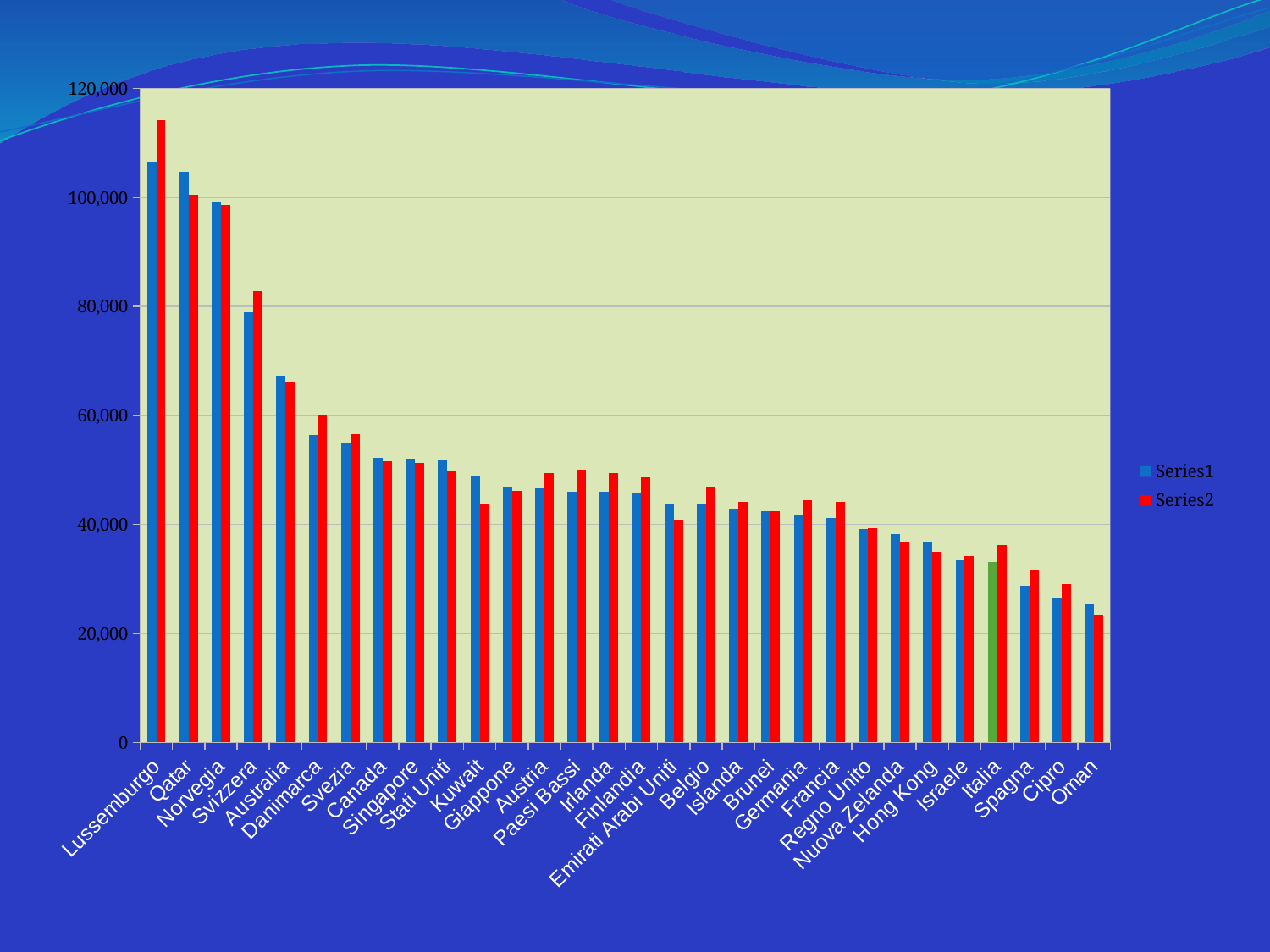
Is the Series1 value for Lussemburgo greater or less than 100,000? greater Which country has the lowest Series2 value? Oman Which country has the lowest Series1 value? Oman Is the Series2 value for Svizzera greater or less than 80,000? greater Is the Series1 value for Italia greater or less than 40,000? less For Qatar, which is larger, the Series1 value or the Series2 value? Series1 Which country has the highest Series2 value? Lussemburgo How many series does the legend list? 2 How many countries are shown on the x axis? 30 Do the Series1 values generally rise or fall from left to right along the x axis? fall For Kuwait, which is larger, the Series1 value or the Series2 value? Series1 What kind of chart is shown on the slide? bar chart